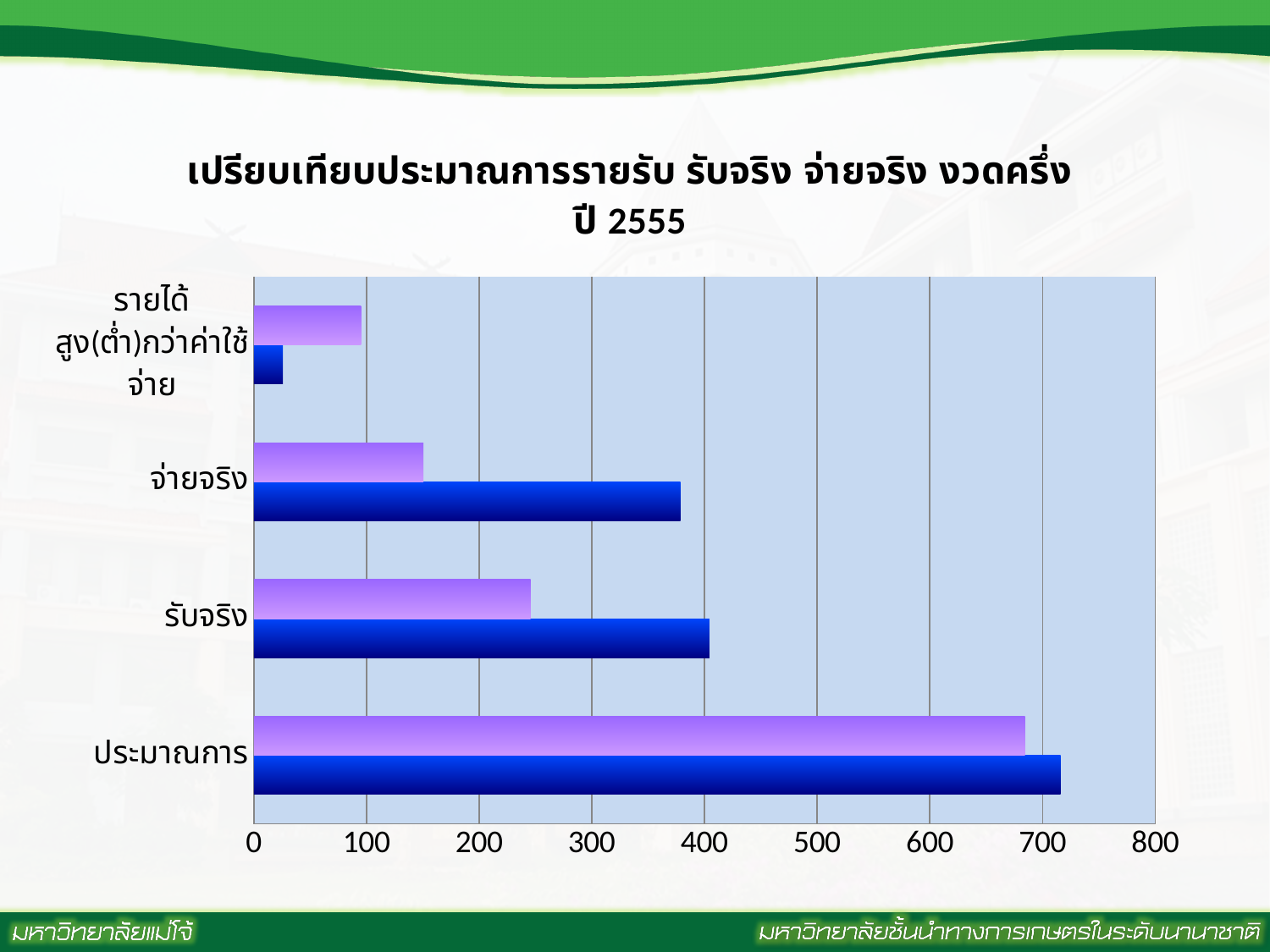
What kind of chart is shown on the slide? bar chart Which category has the shortest purple bar? รายได้สูง(ต่ำ)กว่าค่าใช้จ่าย Which category has the shortest dark blue bar? รายได้สูง(ต่ำ)กว่าค่าใช้จ่าย What is the maximum value shown on the horizontal axis of the chart? 800 Which category has the longest purple bar? ประมาณการ Is the purple bar for รับจริง greater or less than 300? less Is the dark blue bar for จ่ายจริง greater or less than 300? greater Is the dark blue bar for ประมาณการ greater or less than 700? greater Which category has the longest dark blue bar? ประมาณการ How many categories are shown on the vertical axis of the chart? 4 For รับจริง, which bar is longer, the purple bar or the dark blue bar? the dark blue bar